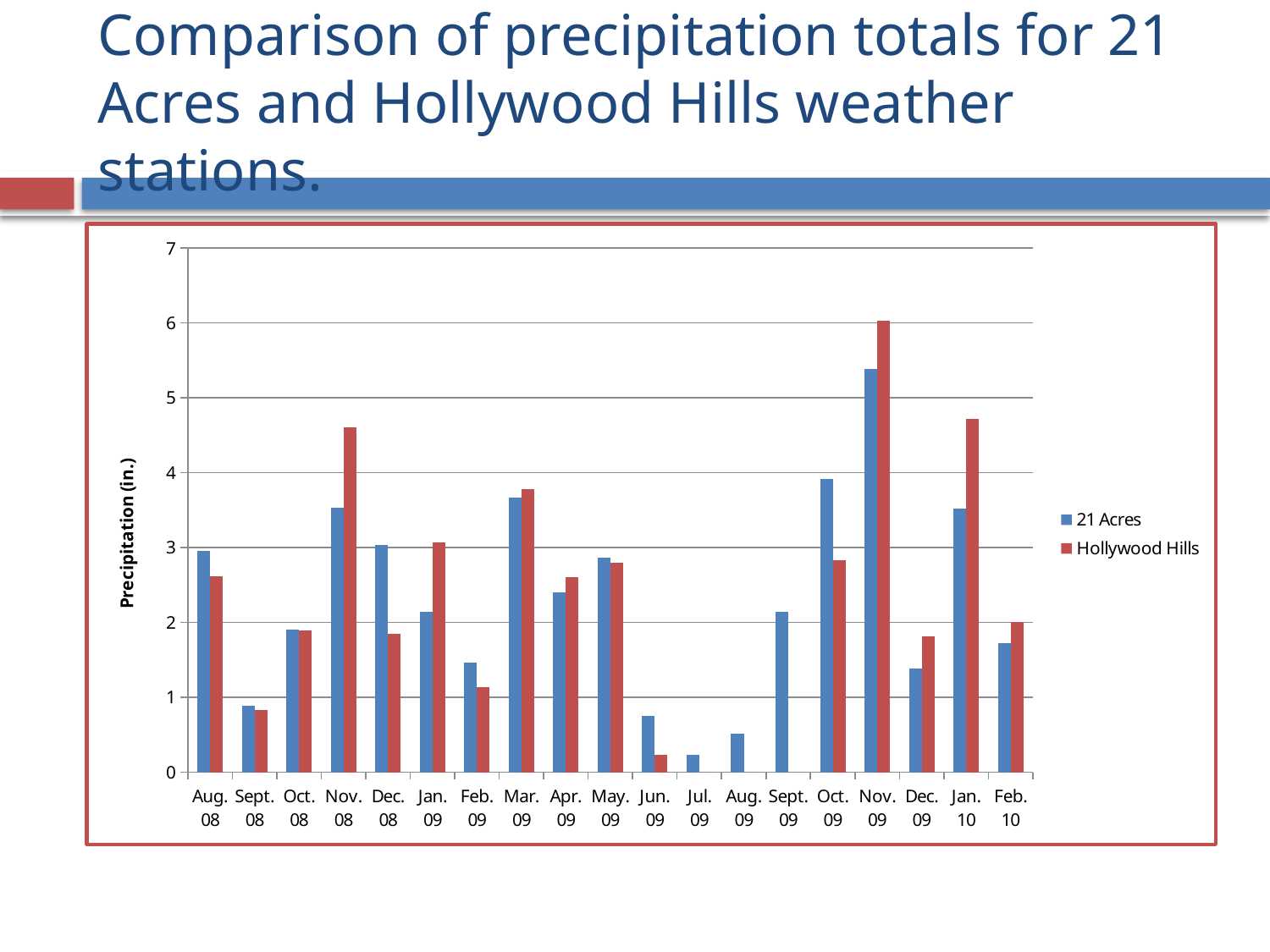
Is the 21 Acres value for Nov. 09 greater or less than 5? greater In which month is the 21 Acres precipitation highest? Nov. 09 What kind of chart is shown on the slide? bar chart In which month is the Hollywood Hills precipitation highest? Nov. 09 Is the Hollywood Hills value for Nov. 08 greater or less than 4? greater For Dec. 08, which station has the larger precipitation total, 21 Acres or Hollywood Hills? 21 Acres In which month is the 21 Acres precipitation lowest? Jul. 09 For Jan. 10, which station has the larger precipitation total, 21 Acres or Hollywood Hills? Hollywood Hills What is the label on the vertical axis? Precipitation (in.) How many series does the legend list? 2 How many months (categories) are shown on the x axis? 19 Is the 21 Acres value for Jun. 09 greater or less than 1? less